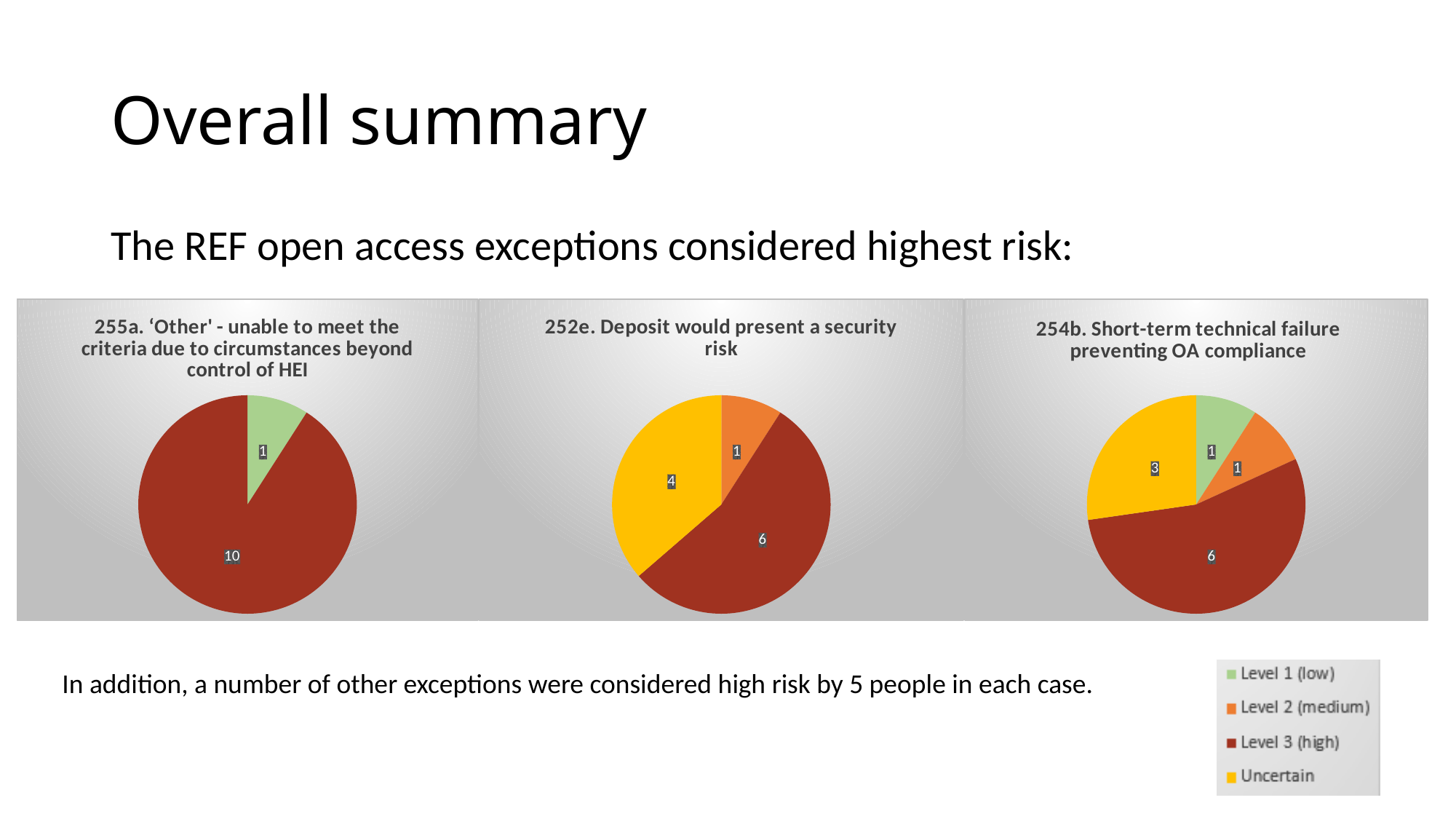
In the pie chart titled '252e. Deposit would present a security risk', which category has the smallest slice? Level 2 (medium) In the pie chart titled '252e. Deposit would present a security risk', what is the value for Level 3 (high)? 6 What is the total of all slices in the pie chart titled '252e. Deposit would present a security risk'? 11 In the pie chart titled '255a. ‘Other' - unable to meet the criteria due to circumstances beyond control of HEI', what is the difference between the Level 3 (high) value and the Level 1 (low) value? 9 In the pie chart titled '254b. Short-term technical failure preventing OA compliance', which category has the largest slice? Level 3 (high) In the pie chart titled '252e. Deposit would present a security risk', which is larger, Level 3 (high) or Uncertain? Level 3 (high) In the pie chart titled '252e. Deposit would present a security risk', what is the value for Uncertain? 4 In the pie chart titled '254b. Short-term technical failure preventing OA compliance', what is the value for Uncertain? 3 In the pie chart titled '255a. ‘Other' - unable to meet the criteria due to circumstances beyond control of HEI', what is the value for Level 3 (high)? 10 How many entries does the legend on the slide list? 4 How many slices does the pie chart titled '254b. Short-term technical failure preventing OA compliance' have? 4 In the pie chart titled '255a. ‘Other' - unable to meet the criteria due to circumstances beyond control of HEI', what is the value for Level 1 (low)? 1